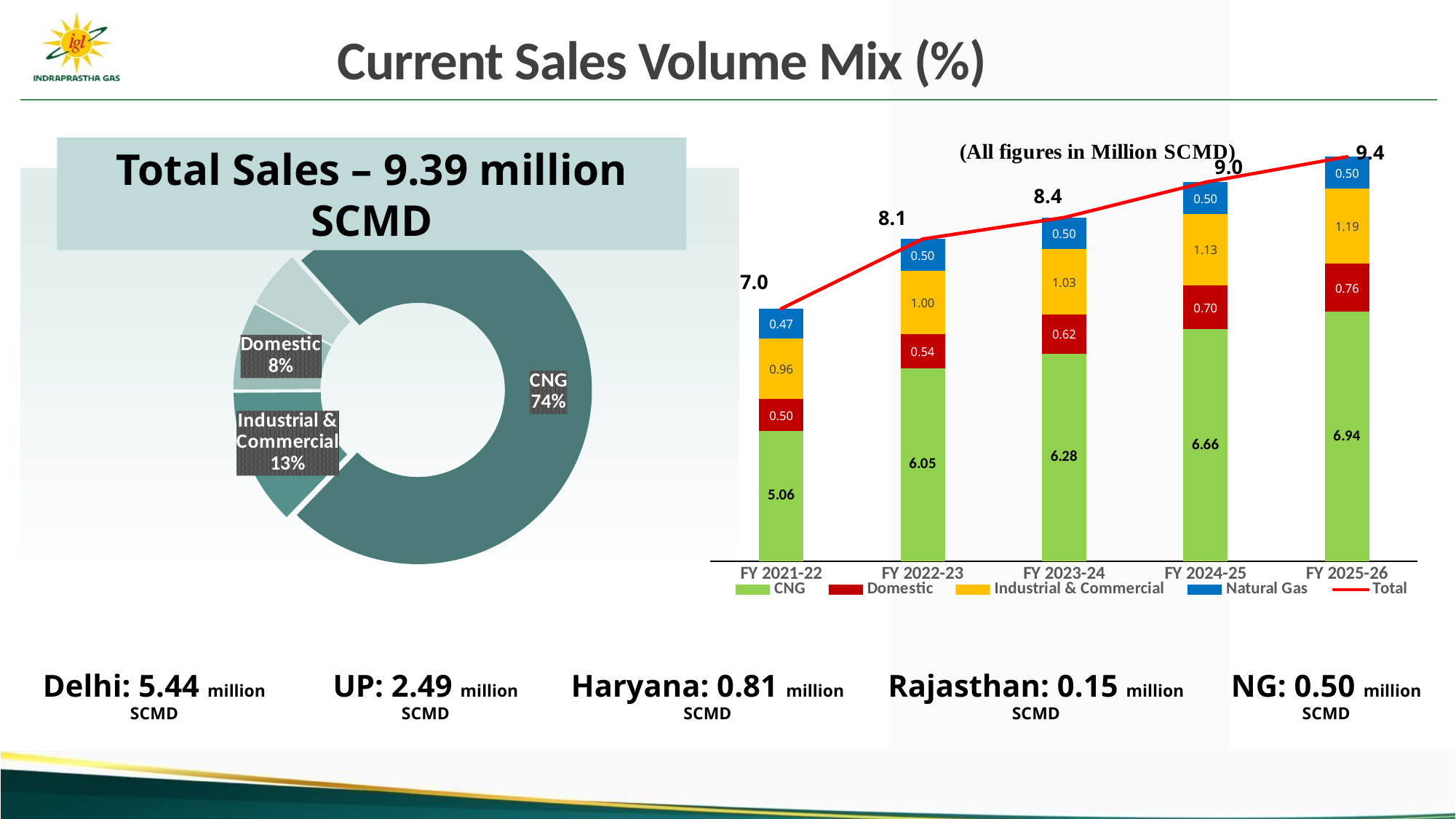
In the stacked bar chart on the right, what is the Industrial & Commercial value for FY 2022-23? 1.00 In the stacked bar chart on the right, what is the Natural Gas value for FY 2021-22? 0.47 In the donut chart on the left, which is larger, the Industrial & Commercial share or the Domestic share? Industrial & Commercial In the stacked bar chart on the right, what is the CNG value for FY 2023-24? 6.28 In the stacked bar chart on the right, what is the Total value shown for FY 2024-25? 9.0 In the stacked bar chart on the right, which fiscal year has the highest CNG value? FY 2025-26 In the stacked bar chart on the right, does the Total value rise or fall from FY 2021-22 to FY 2025-26? rise In the stacked bar chart on the right, how many fiscal years are shown on the x axis? 5 In the donut chart on the left, what share of sales does CNG account for? 74% In the stacked bar chart on the right, which fiscal year has the lowest Total value? FY 2021-22 In the stacked bar chart on the right, what is the difference between the CNG values for FY 2025-26 and FY 2021-22? 1.88 In the stacked bar chart on the right, what is the Domestic value for FY 2025-26? 0.76